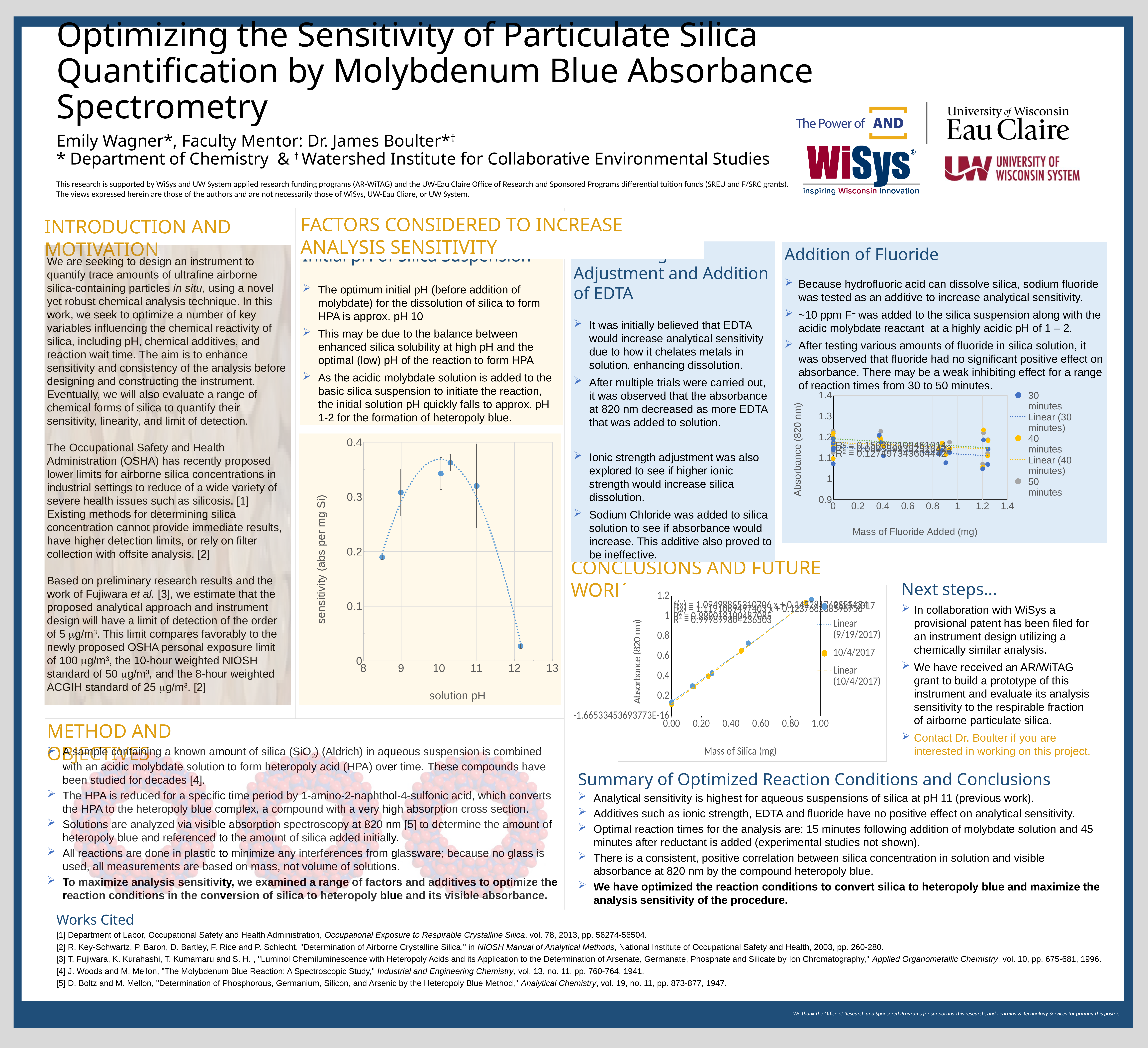
In the Addition of Fluoride chart, are the absorbance values at 0 mg fluoride greater or less than 1.4? less In the Absorbance versus Mass of Silica chart, does absorbance rise or fall as the mass of silica increases? rise In the sensitivity versus solution pH chart, is the sensitivity at the lowest pH (about 8.5) greater or less than 0.2? less In the Addition of Fluoride chart, what is the x-axis title? Mass of Fluoride Added (mg) In the sensitivity versus solution pH chart, how many data points are plotted? 6 What kind of chart is the sensitivity versus solution pH chart on the left? scatter chart In the sensitivity versus solution pH chart, is the sensitivity at the highest pH (about 12) greater or less than 0.1? less What is the y-axis title of the sensitivity versus solution pH chart? sensitivity (abs per mg Si) In the sensitivity versus solution pH chart, which is larger: the sensitivity at pH 9 or at pH 12? pH 9 In the Addition of Fluoride chart (Absorbance vs Mass of Fluoride Added), how many entries does the legend list? 5